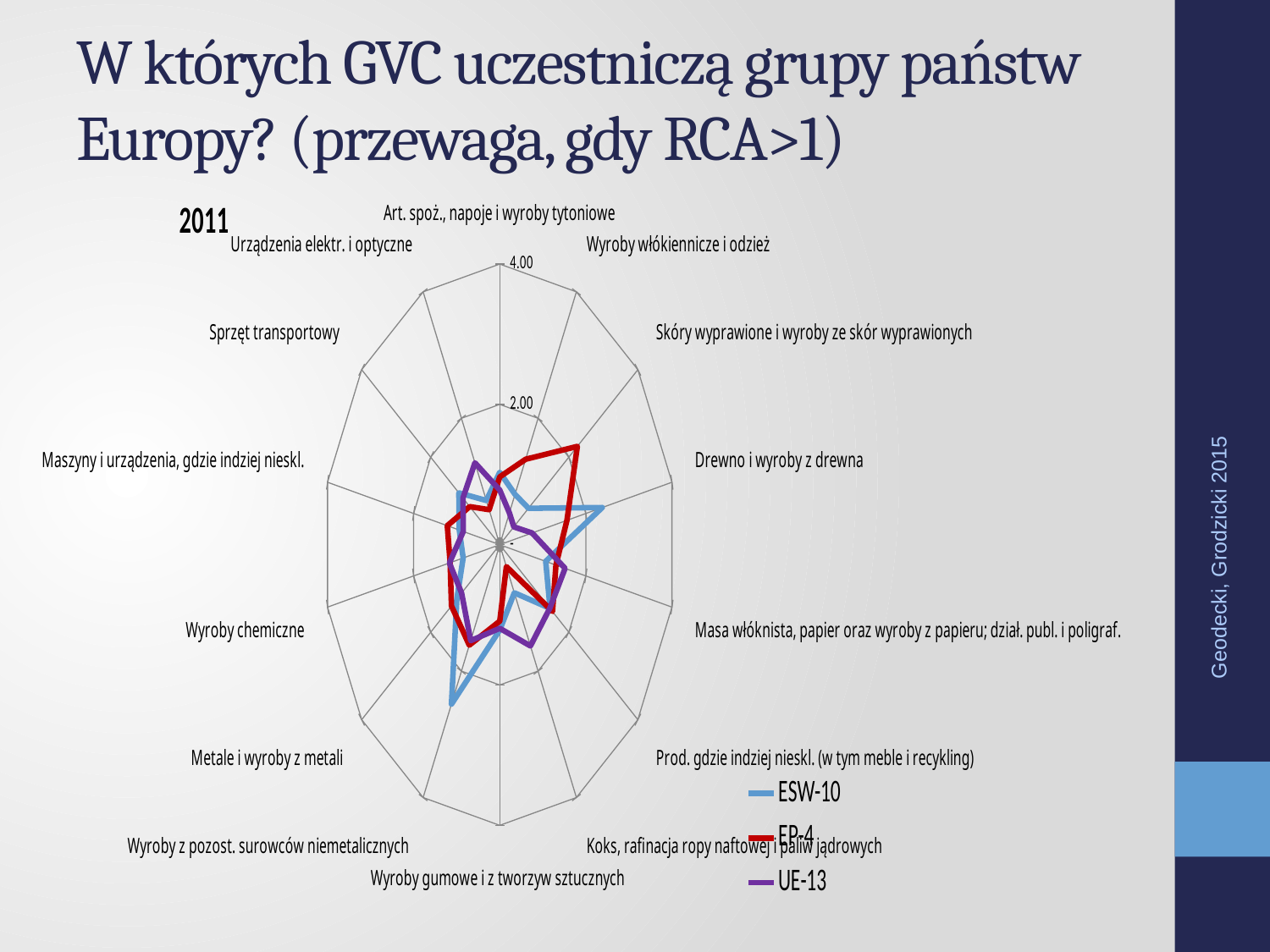
How many series does the legend list? 3 Is the value for EP-4 at 'Skóry wyprawione i wyroby ze skór wyprawionych' greater or less than 4.00? less What is the highest value shown on the chart's axis scale? 4.00 Is the value for ESW-10 at 'Drewno i wyroby z drewna' greater or less than 4.00? less At 'Drewno i wyroby z drewna', which series has the larger value, ESW-10 or UE-13? ESW-10 Which year is shown in the label at the top left of the chart? 2011 What kind of chart is shown on the slide? radar chart How many categories (axes) does the radar chart have? 14 Is the value for ESW-10 at 'Metale i wyroby z metali' greater or less than 2.00? less At 'Skóry wyprawione i wyroby ze skór wyprawionych', which series has the larger value, EP-4 or UE-13? EP-4 Which series is drawn in red? EP-4